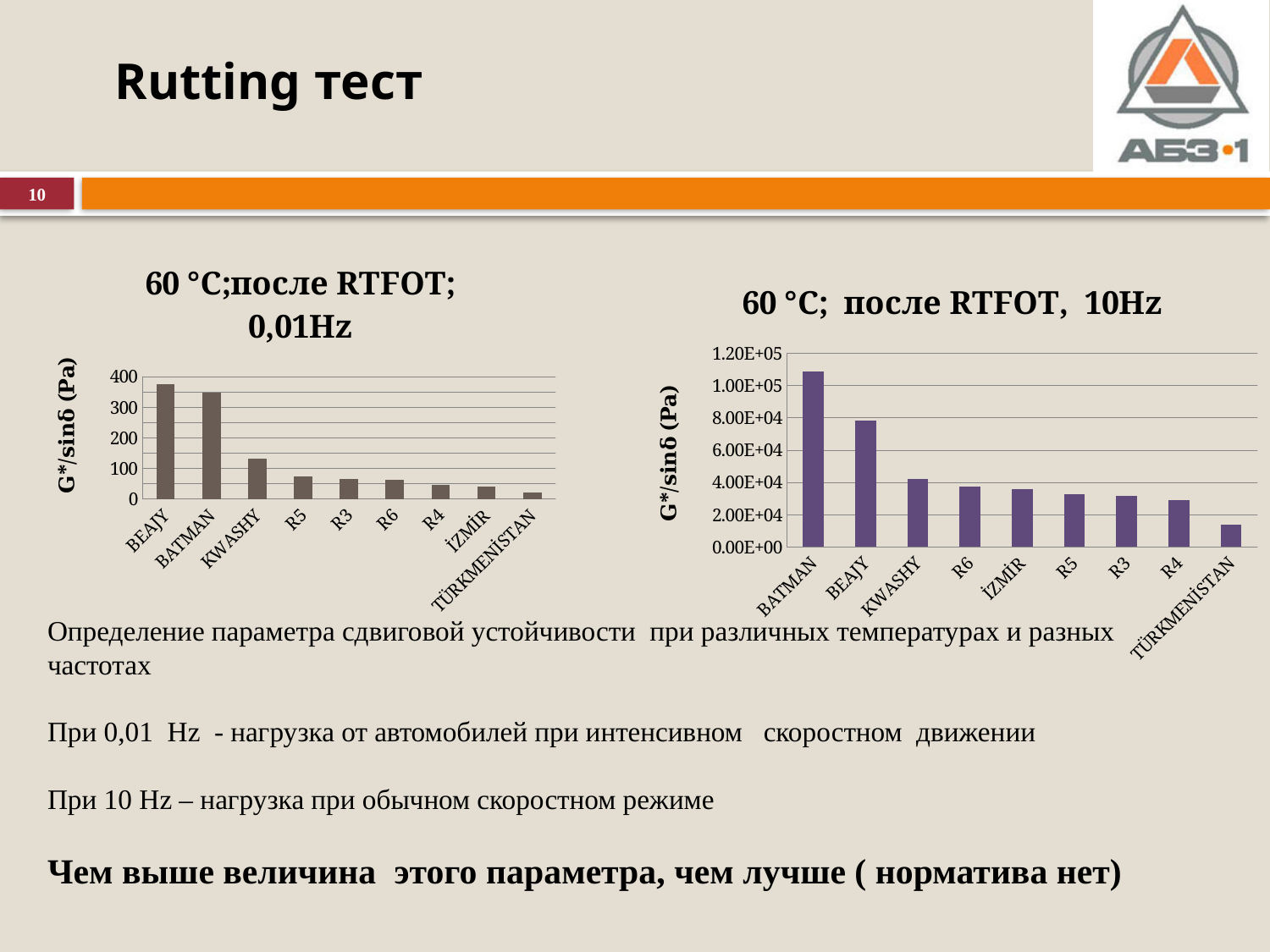
In the right chart (10Hz), do the values rise or fall from left to right along the x axis? fall In the left chart (0,01Hz), is the value for R5 greater or less than 100? less How many categories are shown in the left chart (0,01Hz)? 9 In the left chart (0,01Hz), which category has the highest value? BEAJY What kind of chart is the left chart titled "60 °C;после RTFOT; 0,01Hz"? bar chart In the left chart (0,01Hz), is the value for KWASHY greater or less than 100? greater In the left chart (0,01Hz), which category has the lowest value? TÜRKMENİSTAN What is the y-axis label of the right chart (10Hz)? G*/sinδ (Pa) In the right chart (10Hz), which category has the lowest value? TÜRKMENİSTAN In the right chart (10Hz), which category has the highest value? BATMAN In the right chart (10Hz), is the value for BATMAN greater or less than 1.00E+05? greater In the left chart (0,01Hz), which is larger, the value for KWASHY or the value for R3? KWASHY